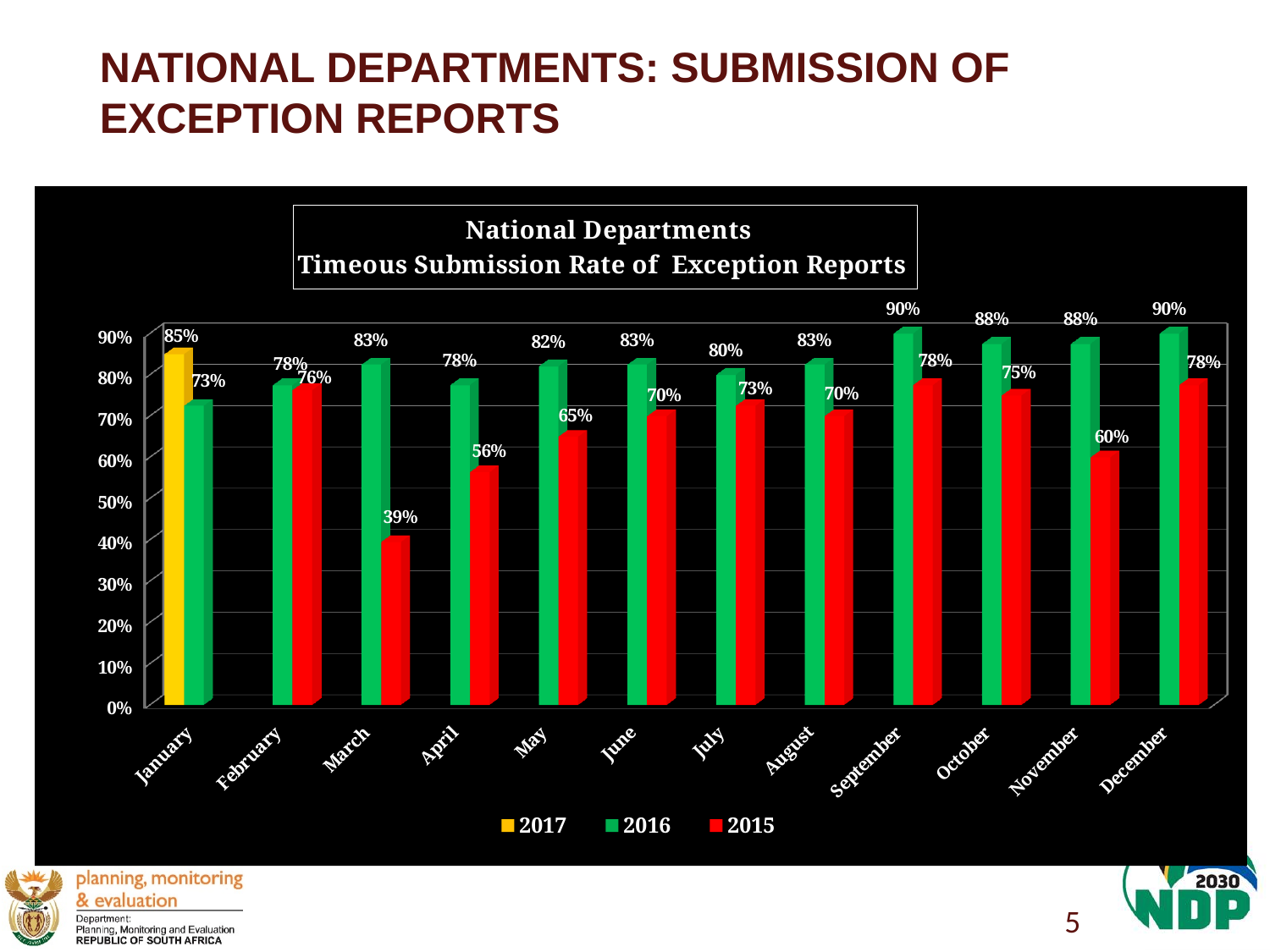
What is the 2017 value for January? 85% What is the title of the chart? National Departments Timeous Submission Rate of Exception Reports Which month has the lowest 2015 value? March How many series does the legend list? 3 What type of chart is shown on the slide? bar chart Which is larger in January, the 2017 value or the 2016 value? 2017 What is the difference between the 2016 and 2015 values for March? 44% What is the 2016 value for November? 88% Which month has the lowest 2016 value? January What is the 2015 value for March? 39% What is the difference between the 2016 and 2015 values for November? 28% How many months are shown on the x axis? 12